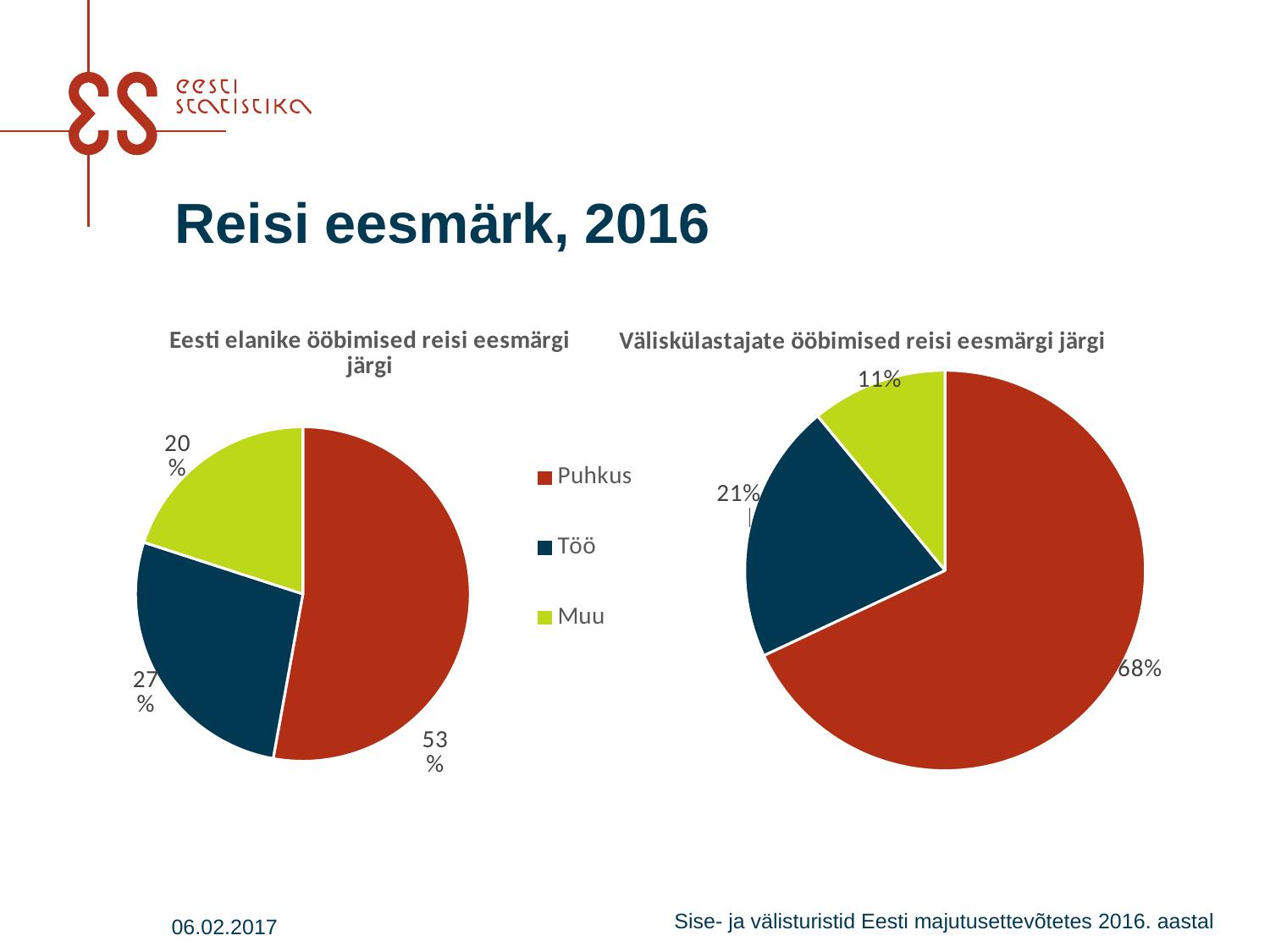
In the chart titled "Eesti elanike ööbimised reisi eesmärgi järgi", what share does Töö have? 27% In the chart titled "Väliskülastajate ööbimised reisi eesmärgi järgi", which category has the smallest slice? Muu How many categories does the legend on the slide list? 3 What type of chart is the chart titled "Väliskülastajate ööbimised reisi eesmärgi järgi"? Pie chart In the chart titled "Eesti elanike ööbimised reisi eesmärgi järgi", what share does Puhkus have? 53% Is the Töö share larger in the chart titled "Eesti elanike ööbimised reisi eesmärgi järgi" or in the chart titled "Väliskülastajate ööbimised reisi eesmärgi järgi"? Eesti elanike ööbimised reisi eesmärgi järgi In the chart titled "Eesti elanike ööbimised reisi eesmärgi järgi", what share does Muu have? 20% In the chart titled "Väliskülastajate ööbimised reisi eesmärgi järgi", what share does Muu have? 11% In the chart titled "Väliskülastajate ööbimised reisi eesmärgi järgi", what share does Töö have? 21% In the chart titled "Eesti elanike ööbimised reisi eesmärgi järgi", which category has the largest slice? Puhkus In the chart titled "Eesti elanike ööbimised reisi eesmärgi järgi", what is the difference between the Puhkus and Töö shares? 26% In the chart titled "Väliskülastajate ööbimised reisi eesmärgi järgi", what share does Puhkus have? 68%